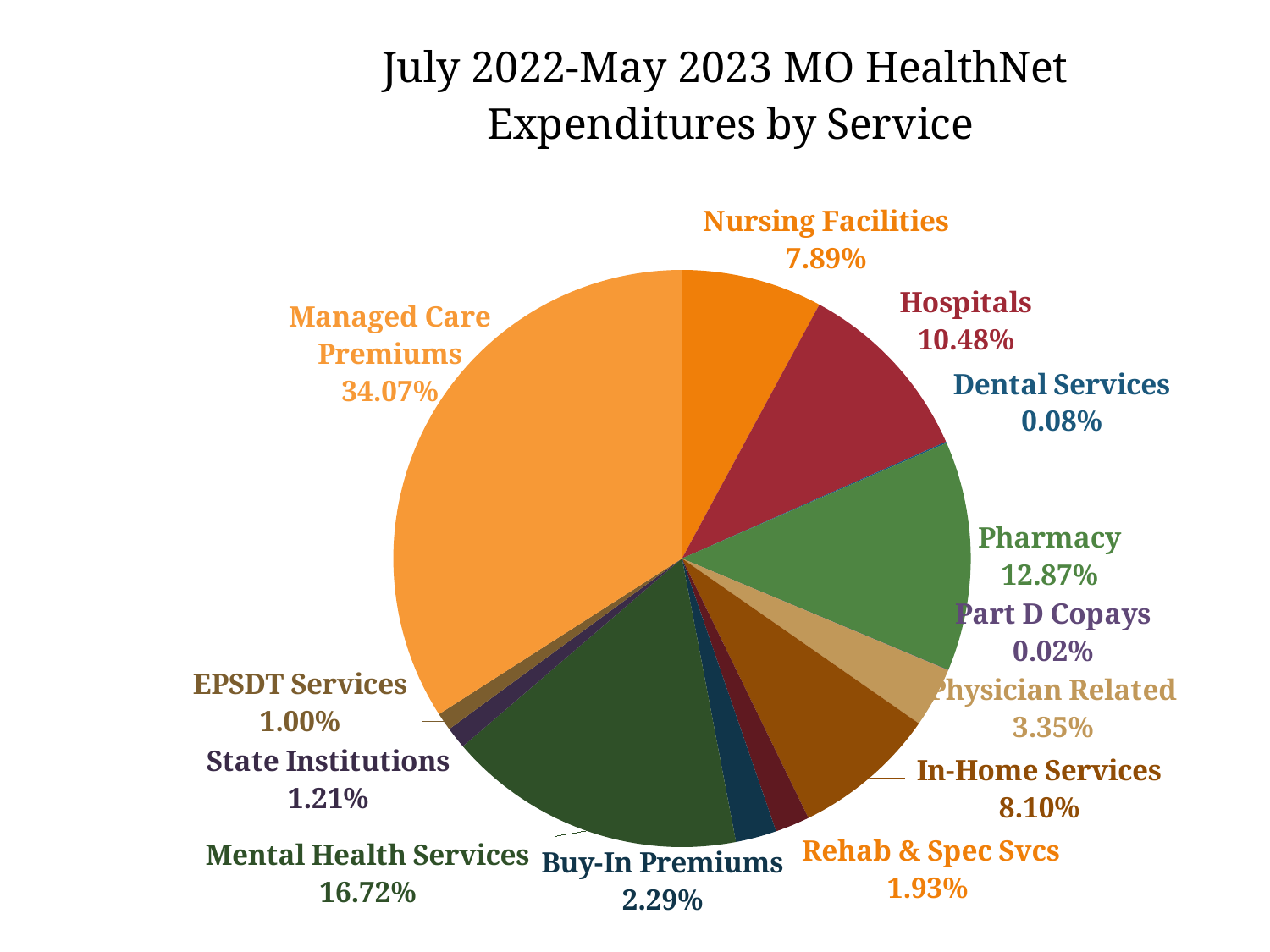
Which service category has the largest share of expenditures? Managed Care Premiums What percentage is shown for Mental Health Services? 16.72% How many service categories are shown in the pie chart? 13 What type of chart is shown on the slide? Pie chart Which service category has the smallest share of expenditures? Part D Copays What is the title of the chart? July 2022-May 2023 MO HealthNet Expenditures by Service What is the difference in percentage points between Pharmacy and Nursing Facilities? 4.98 Which is larger, Pharmacy or Hospitals? Pharmacy What share of expenditures is Managed Care Premiums? 34.07% What is the combined share of Buy-In Premiums and Rehab & Spec Svcs? 4.22% What is the value for In-Home Services? 8.10% What percentage is shown for Part D Copays? 0.02%